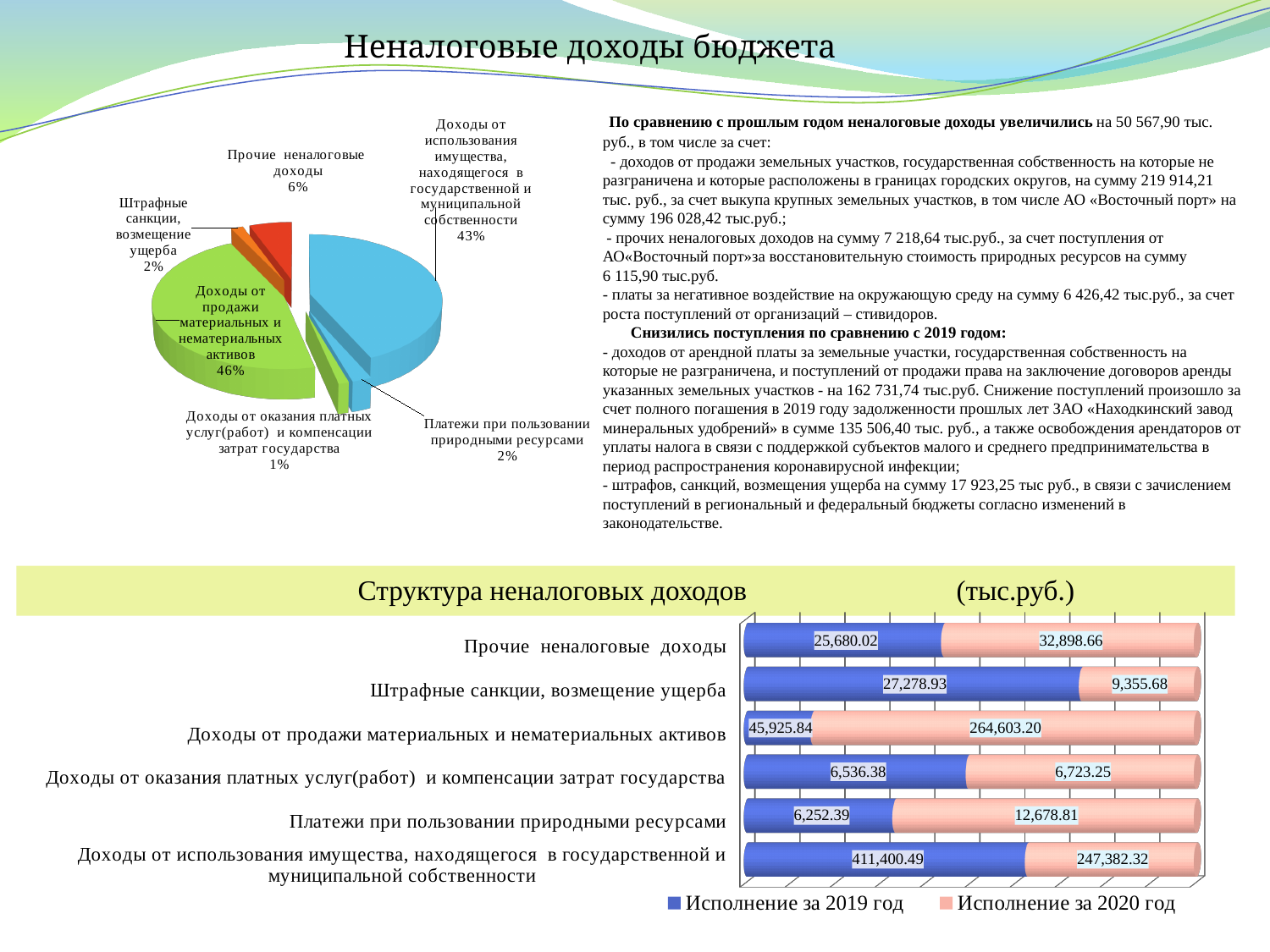
How many series does the legend of the chart 'Структура неналоговых доходов' list? 2 In the pie chart, which category has the smallest share? Доходы от оказания платных услуг(работ) и компенсации затрат государства How many slices does the pie chart have? 6 In the chart 'Структура неналоговых доходов', what is the value of Исполнение за 2020 год for Доходы от продажи материальных и нематериальных активов? 264,603.20 In the pie chart, what share do Доходы от продажи материальных и нематериальных активов have? 46% In the chart 'Структура неналоговых доходов', which is larger for Штрафные санкции, возмещение ущерба: Исполнение за 2019 год or Исполнение за 2020 год? Исполнение за 2019 год In the chart 'Структура неналоговых доходов', what is the difference between Исполнение за 2020 год and Исполнение за 2019 год for Прочие неналоговые доходы? 7,218.64 In the pie chart, which category has the largest share? Доходы от продажи материальных и нематериальных активов In the chart 'Структура неналоговых доходов', what is the value of Исполнение за 2020 год for Штрафные санкции, возмещение ущерба? 9,355.68 In the chart 'Структура неналоговых доходов', what is the total of the two series for Платежи при пользовании природными ресурсами? 18,931.20 In the pie chart, what share do Доходы от использования имущества, находящегося в государственной и муниципальной собственности have? 43% In the chart 'Структура неналоговых доходов', what is the value of Исполнение за 2019 год for Доходы от использования имущества, находящегося в государственной и муниципальной собственности? 411,400.49